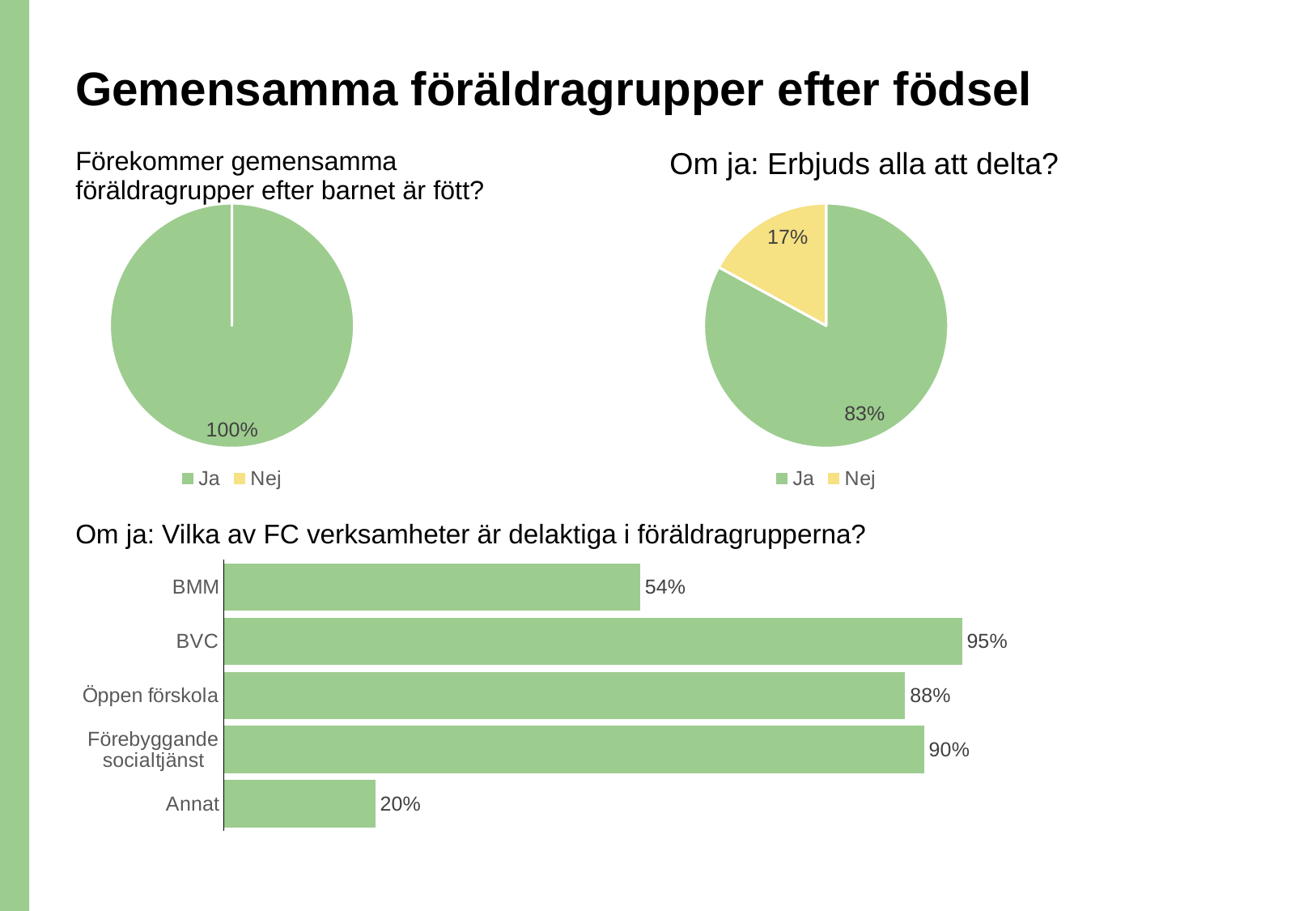
In the bar chart 'Om ja: Vilka av FC verksamheter är delaktiga i föräldragrupperna?', which category has the highest value? BVC In the bar chart 'Om ja: Vilka av FC verksamheter är delaktiga i föräldragrupperna?', what is the value for Annat? 20% In the pie chart 'Om ja: Erbjuds alla att delta?', what share does Ja have? 83% In the pie chart 'Om ja: Erbjuds alla att delta?', what share does Nej have? 17% In the bar chart 'Om ja: Vilka av FC verksamheter är delaktiga i föräldragrupperna?', what is the difference between the values for BVC and BMM? 41% What kind of chart is 'Om ja: Vilka av FC verksamheter är delaktiga i föräldragrupperna?'? Bar chart In the bar chart 'Om ja: Vilka av FC verksamheter är delaktiga i föräldragrupperna?', which category has the lowest value? Annat How many categories does the bar chart 'Om ja: Vilka av FC verksamheter är delaktiga i föräldragrupperna?' show? 5 In the bar chart 'Om ja: Vilka av FC verksamheter är delaktiga i föräldragrupperna?', what is the value for BVC? 95% How many series does the legend of the pie chart 'Om ja: Erbjuds alla att delta?' list? 2 In the pie chart 'Förekommer gemensamma föräldragrupper efter barnet är fött?', what share does Ja have? 100% In the bar chart 'Om ja: Vilka av FC verksamheter är delaktiga i föräldragrupperna?', which is larger, Öppen förskola or Förebyggande socialtjänst? Förebyggande socialtjänst